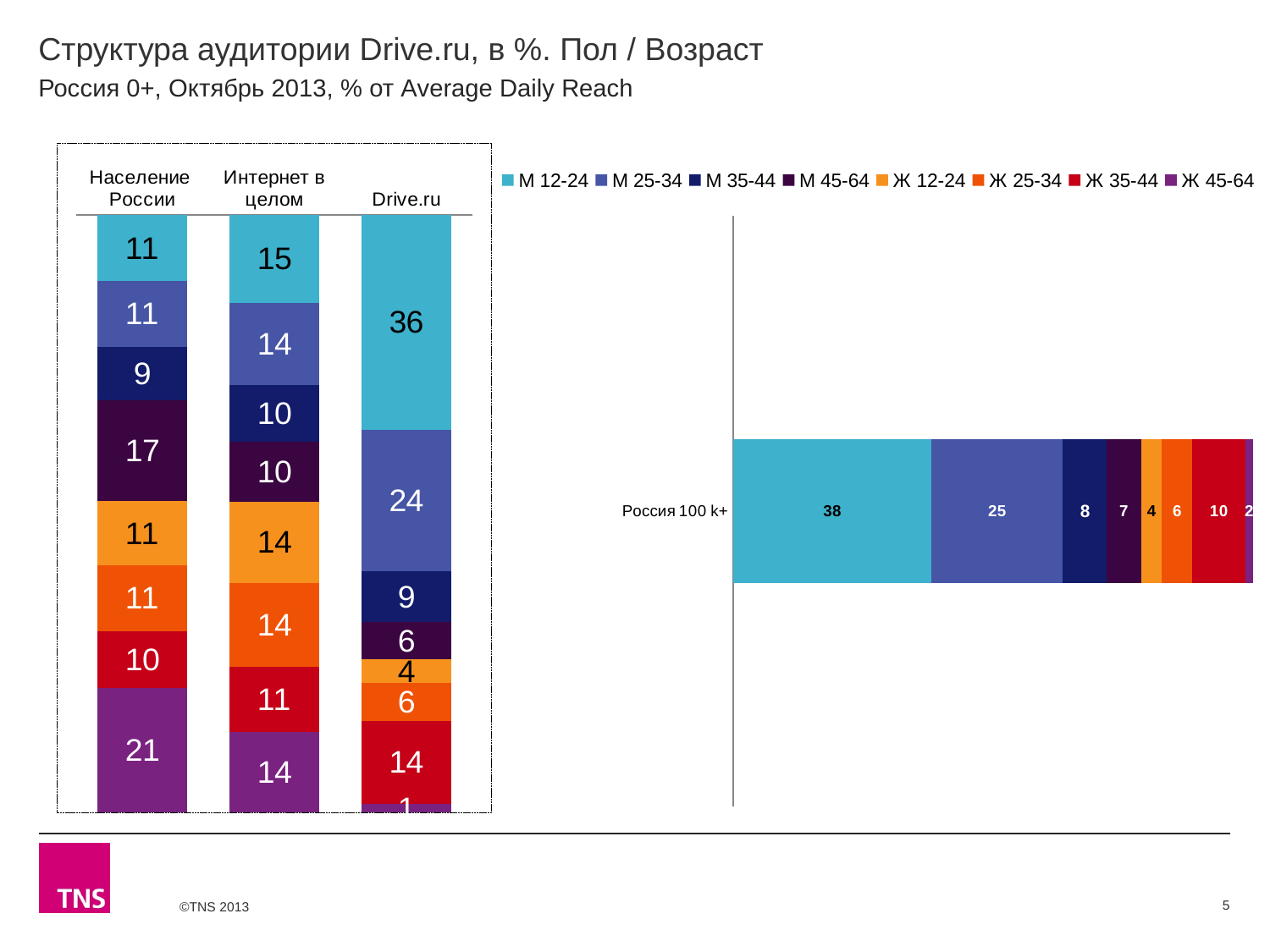
In the left chart, what is the value of the М 12-24 segment for Drive.ru? 36 How many series does the legend list? 8 In the right chart, which segment of the Россия 100 k+ bar is the smallest? Ж 45-64 In the left chart, which is larger: the Ж 35-44 value for Drive.ru or for Население России? Drive.ru In the right chart, what is the total of the Россия 100 k+ bar? 100 In the left chart, what is the value of the Ж 45-64 segment for Население России? 21 In the right chart, what is the value of the М 25-34 segment for Россия 100 k+? 25 What type of chart is the right chart? Stacked bar chart How many bars (categories) does the left chart show? 3 In the left chart, what is the difference between the М 12-24 values for Drive.ru and Интернет в целом? 21 In the left chart, what is the value of the М 35-44 segment for Интернет в целом? 10 In the right chart, which segment of the Россия 100 k+ bar is the largest? М 12-24